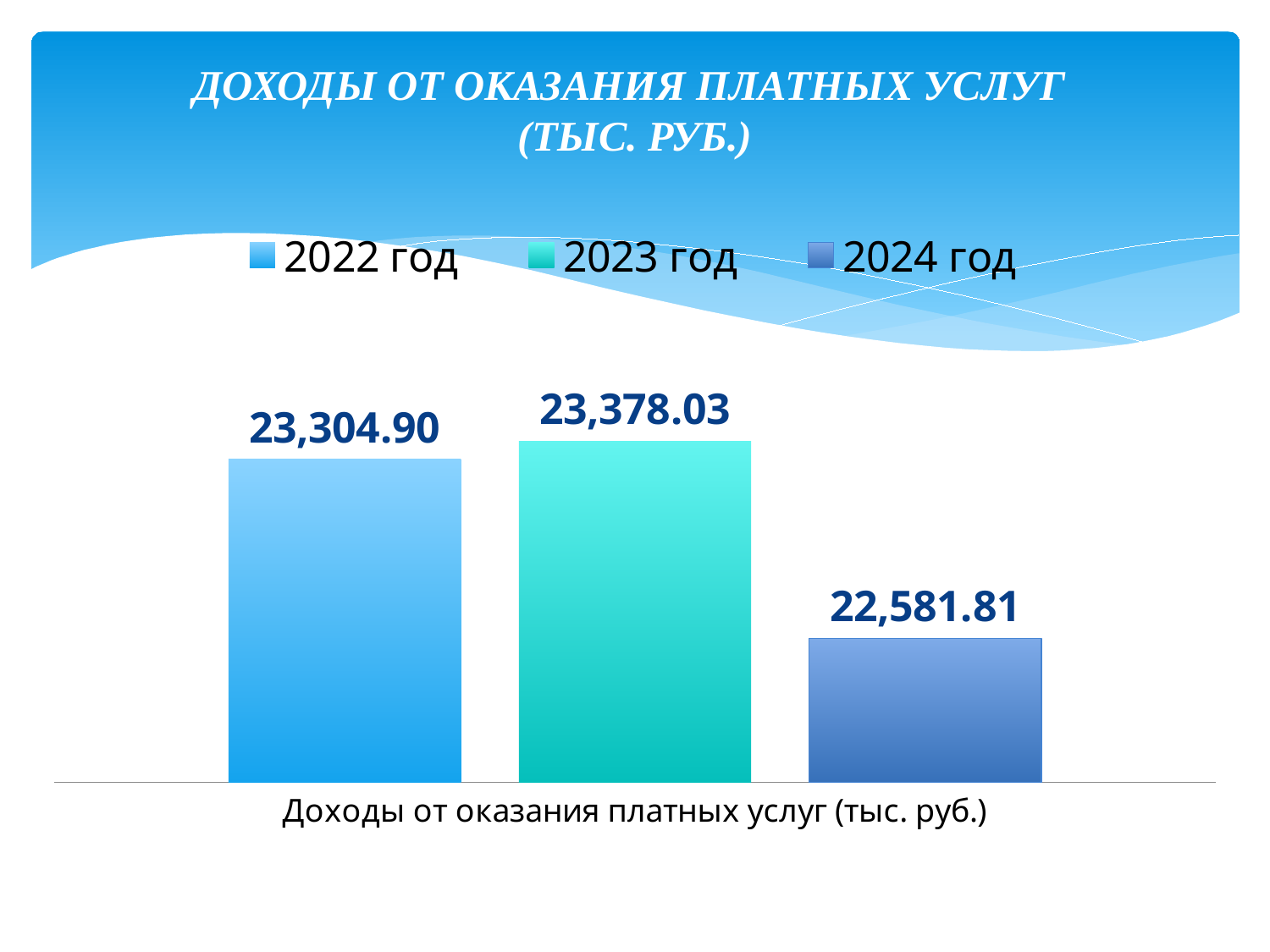
Which year has the lowest value? 2024 год What is the difference between the values for 2022 год and 2024 год? 723.09 What kind of chart is shown on the slide? bar chart How many series does the legend list? 3 Which year has the highest value? 2023 год What is the value for 2022 год? 23,304.90 Which is larger, the value for 2022 год or the value for 2024 год? 2022 год What is the value for 2023 год? 23,378.03 What is the value for 2024 год? 22,581.81 What is the difference between the values for 2023 год and 2022 год? 73.13 What is the title of the chart? ДОХОДЫ ОТ ОКАЗАНИЯ ПЛАТНЫХ УСЛУГ (ТЫС. РУБ.) Do the values rise or fall from 2023 год to 2024 год? fall